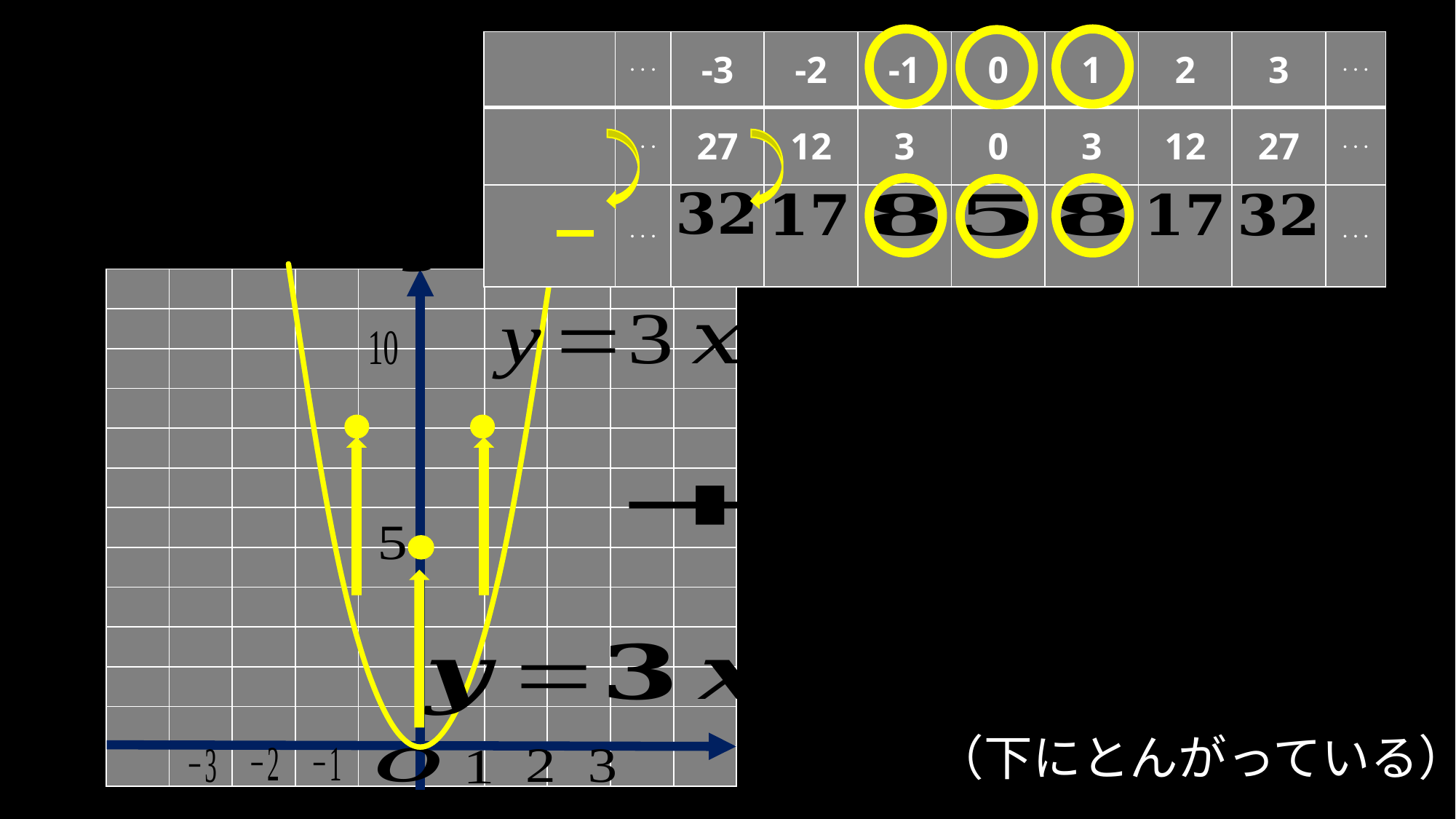
In the table at the top, what value is shown in the third row for x = 0? 5 In the table at the top, what value is shown in the third row for x = 2? 17 In the table at the top, what is the difference between the third-row value and the second-row value for x = 3? 5 On the graph at the bottom left, is the y value of the plotted point at x = 1 greater or less than 5? greater What kind of chart is shown at the bottom left of the slide? line chart (parabola curve) On the graph at the bottom left, what is the y value of the plotted point at x = 0? 5 How many yellow points are plotted on the graph at the bottom left? 3 On the graph at the bottom left, is the y value of the plotted point at x = -1 greater or less than 10? less In the table at the top, which is larger: the third-row value for x = -2 or for x = 1? x = -2 In the table at the top, which x value has the lowest value in the second row? 0 On the graph at the bottom left, do the y values rise or fall as x increases from 0 to 3? rise In the table at the top, what value is shown in the second row for x = -3? 27